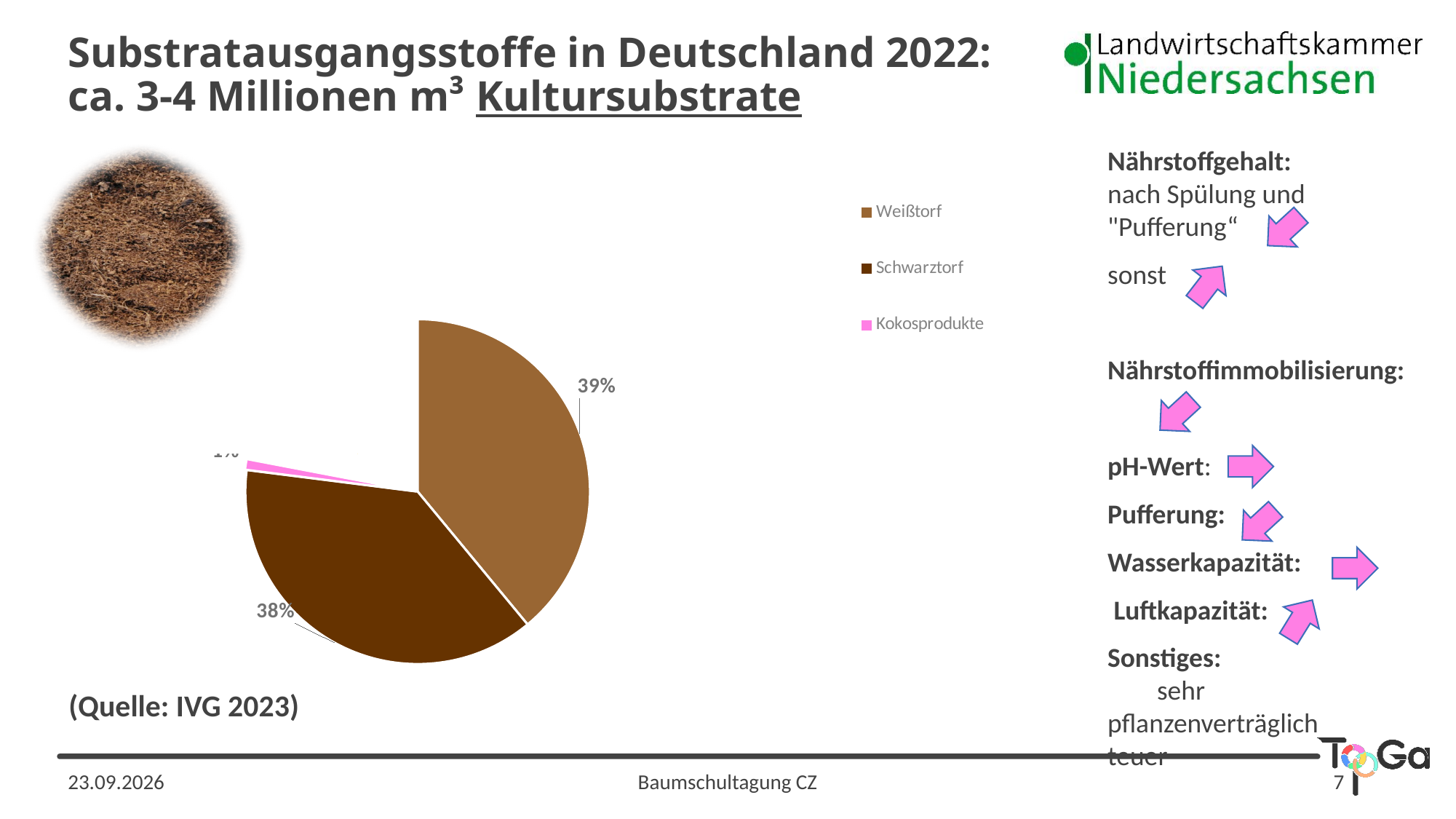
Which category has the largest slice in the pie chart? Weißtorf What source is cited for the pie chart data? IVG 2023 Which is larger in the pie chart, the share of Weißtorf or the share of Schwarztorf? Weißtorf How many categories does the legend of the pie chart list? 3 What is the difference in percentage points between the Weißtorf and Schwarztorf slices? 1% What is the combined share of Weißtorf and Schwarztorf in the pie chart? 77% What percentage share does Weißtorf have in the pie chart? 39% Which category has the smallest slice in the pie chart? Kokosprodukte What percentage share does Schwarztorf have in the pie chart? 38% Which colour represents Kokosprodukte in the pie chart? Pink What kind of chart is shown on the slide? Pie chart